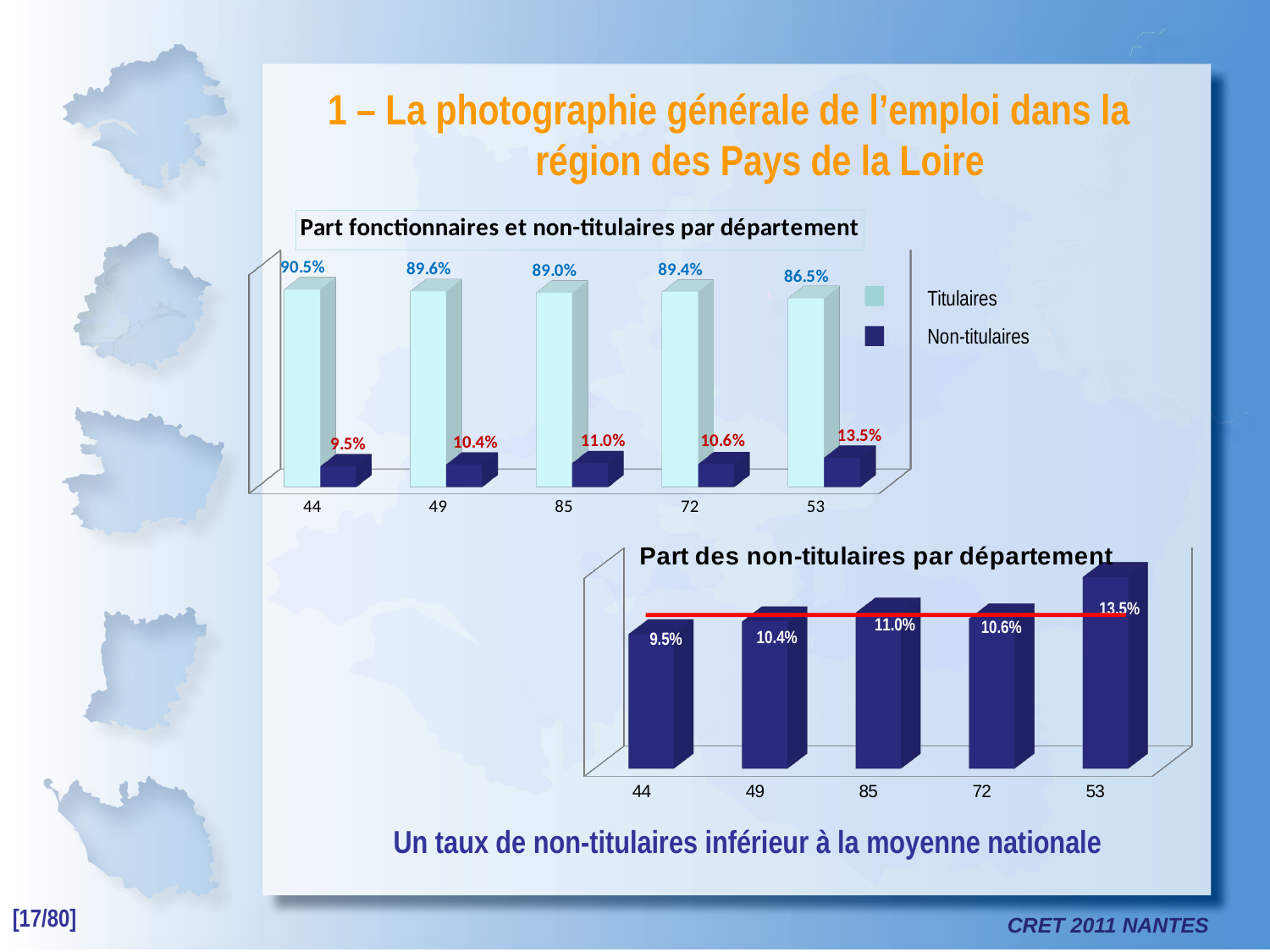
In the chart 'Part fonctionnaires et non-titulaires par département', how many series does the legend list? 2 In the chart 'Part des non-titulaires par département', how many départements are shown? 5 In the chart 'Part des non-titulaires par département', which is larger, the value for département 85 or for département 72? 85 In the chart 'Part fonctionnaires et non-titulaires par département', which département has the lowest Titulaires value? 53 In the chart 'Part fonctionnaires et non-titulaires par département', what is the Titulaires value for département 44? 90.5% In the chart 'Part des non-titulaires par département', which département has the highest value? 53 In the chart 'Part fonctionnaires et non-titulaires par département', what is the difference between the Titulaires values for départements 44 and 53? 4.0% In the chart 'Part des non-titulaires par département', which département has the lowest value? 44 In the chart 'Part fonctionnaires et non-titulaires par département', which département has the highest Titulaires value? 44 In the chart 'Part fonctionnaires et non-titulaires par département', what is the Non-titulaires value for département 85? 11.0% In the chart 'Part des non-titulaires par département', what is the value for département 49? 10.4% What kind of chart is 'Part des non-titulaires par département'? Bar chart